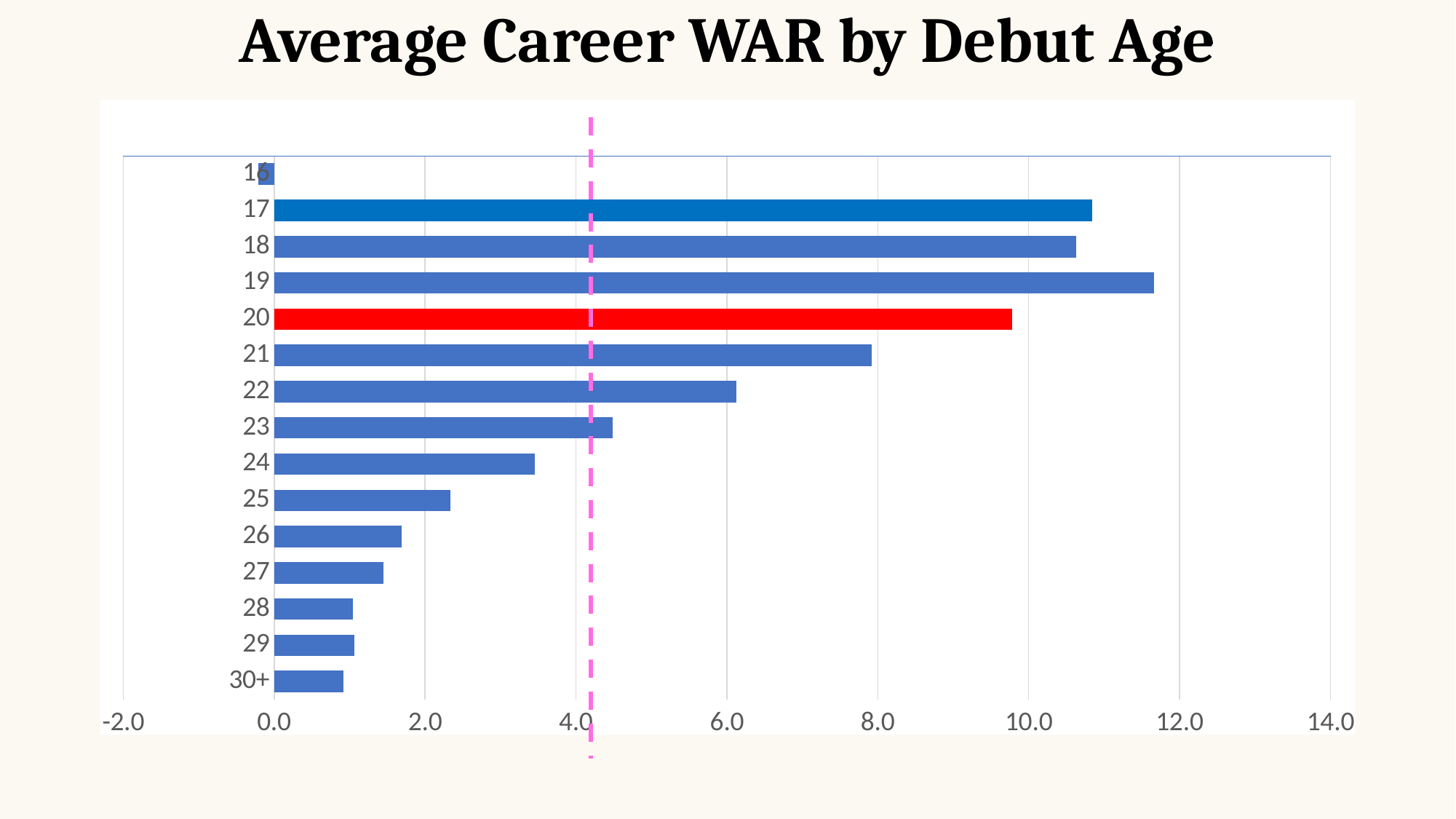
Which debut age has the highest average career WAR? 19 Which has a larger average career WAR, debut age 20 or debut age 21? 20 Which has a larger average career WAR, debut age 22 or debut age 23? 22 Which debut age's bar is coloured red? 20 Which debut age has the lowest average career WAR? 16 Is the value for debut age 26 greater or less than 2.0? less How many debut age categories are plotted in the chart? 15 What kind of chart is shown on the slide? bar chart Is the value for debut age 23 greater or less than 4.0? greater Is the value for debut age 24 greater or less than 4.0? less